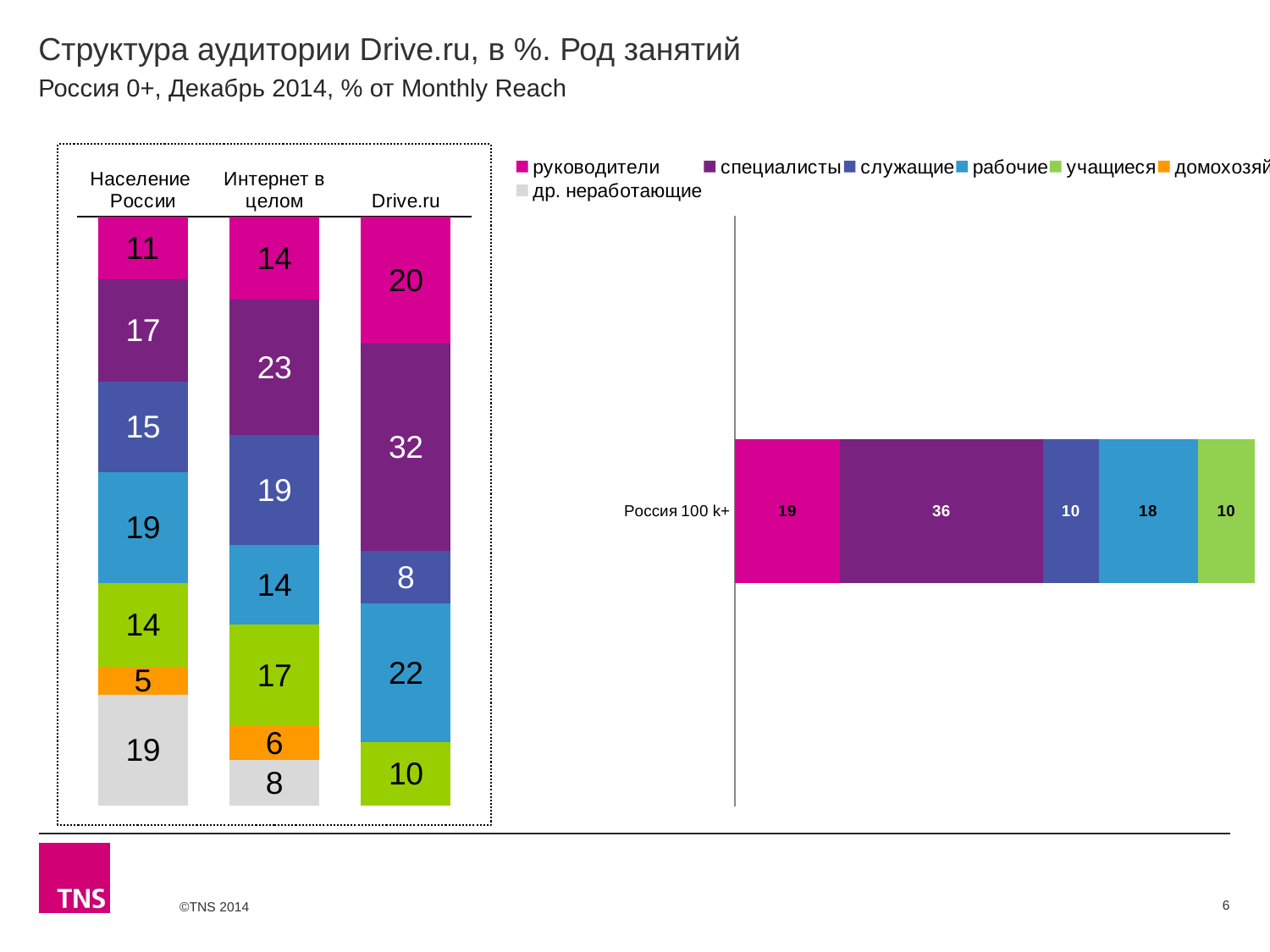
In the right chart (Россия 100 k+), what is the value for специалисты? 36 In the left chart, which is larger: рабочие for Drive.ru or рабочие for Интернет в целом? Drive.ru In the left chart, what is the difference between the специалисты values for Drive.ru and Население России? 15 In the left chart, what is the value for специалисты in the Drive.ru bar? 32 In the left chart, what is the value for учащиеся in the Интернет в целом bar? 17 In the left chart, what is the value for руководители in the Население России bar? 11 What type of chart is the right chart? Stacked horizontal bar chart What is the total of the Россия 100 k+ bar in the right chart? 93 In the left chart, which segment is the largest in the Drive.ru bar? специалисты In the left chart, which segment is the smallest in the Население России bar? домохозяйки (5) How many series does the legend list? 7 How many bars does the left chart show? 3